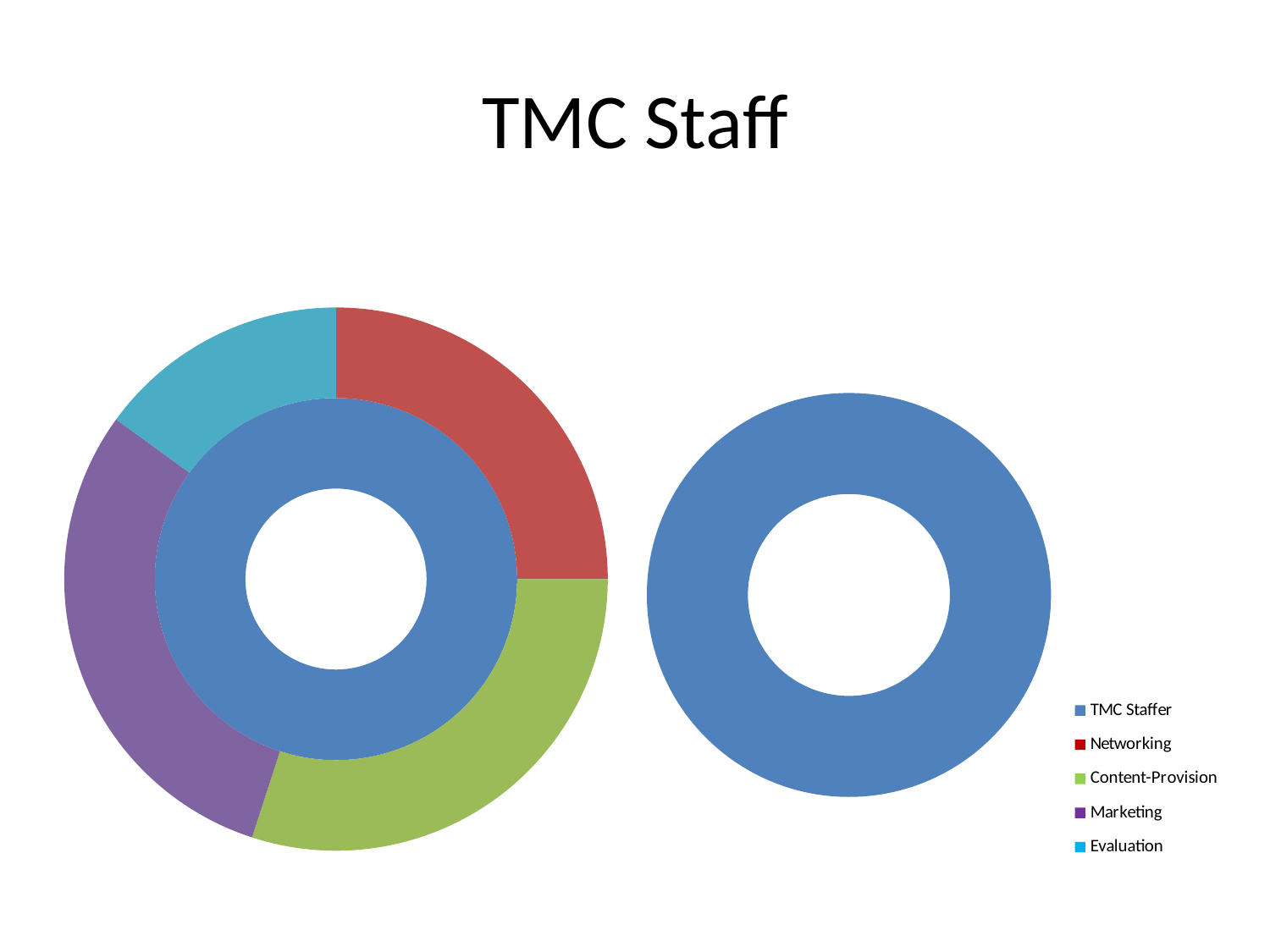
What is the title of the slide's chart? TMC Staff In the left chart, which category does the purple segment represent? Marketing How many entries does the legend list? 5 In the left chart, which category has the smallest segment in the outer ring? Evaluation In the left chart, which is larger in the outer ring: Networking or Evaluation? Networking Which legend entry does the colour of the right-hand doughnut correspond to? TMC Staffer In the left chart, how many segments make up the outer ring? 4 What kind of chart is shown on the left of the slide? doughnut chart In the left chart, which is larger in the outer ring: Content-Provision or Evaluation? Content-Provision In the left chart, which is larger in the outer ring: Marketing or Evaluation? Marketing